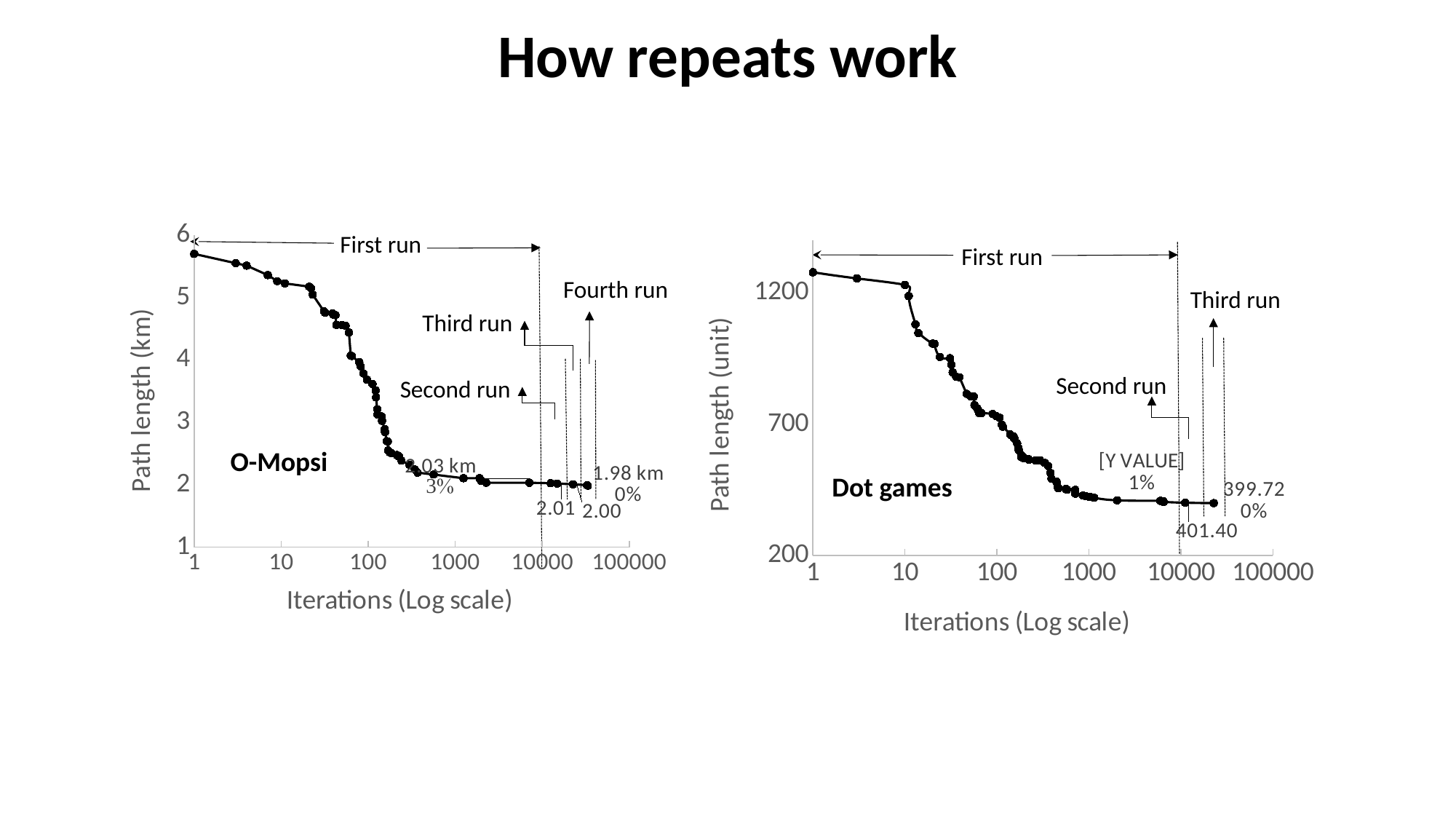
In the O-Mopsi chart, what is the difference between the labelled values 2.03 km and 1.98 km? 0.05 km In the O-Mopsi chart, which is larger: the path length at 10 iterations or at 1000 iterations? 10 iterations What kind of chart is the O-Mopsi chart on the left? line chart In the Dot games chart, what is the difference between the labelled values 401.40 and 399.72? 1.68 In the Dot games chart, what is the final labelled path length value? 399.72 What is the x-axis title of the Dot games chart? Iterations (Log scale) In the Dot games chart, what labelled value appears just before the final 399.72 point? 401.40 In the Dot games chart, is the path length at 1000 iterations greater or less than 700? less In the O-Mopsi chart, do the path length values rise or fall as iterations increase? fall In the O-Mopsi chart, is the path length at 1 iteration greater or less than 5? greater How many runs are annotated on the O-Mopsi chart? 4 In the O-Mopsi chart, what is the final labelled path length value? 1.98 km